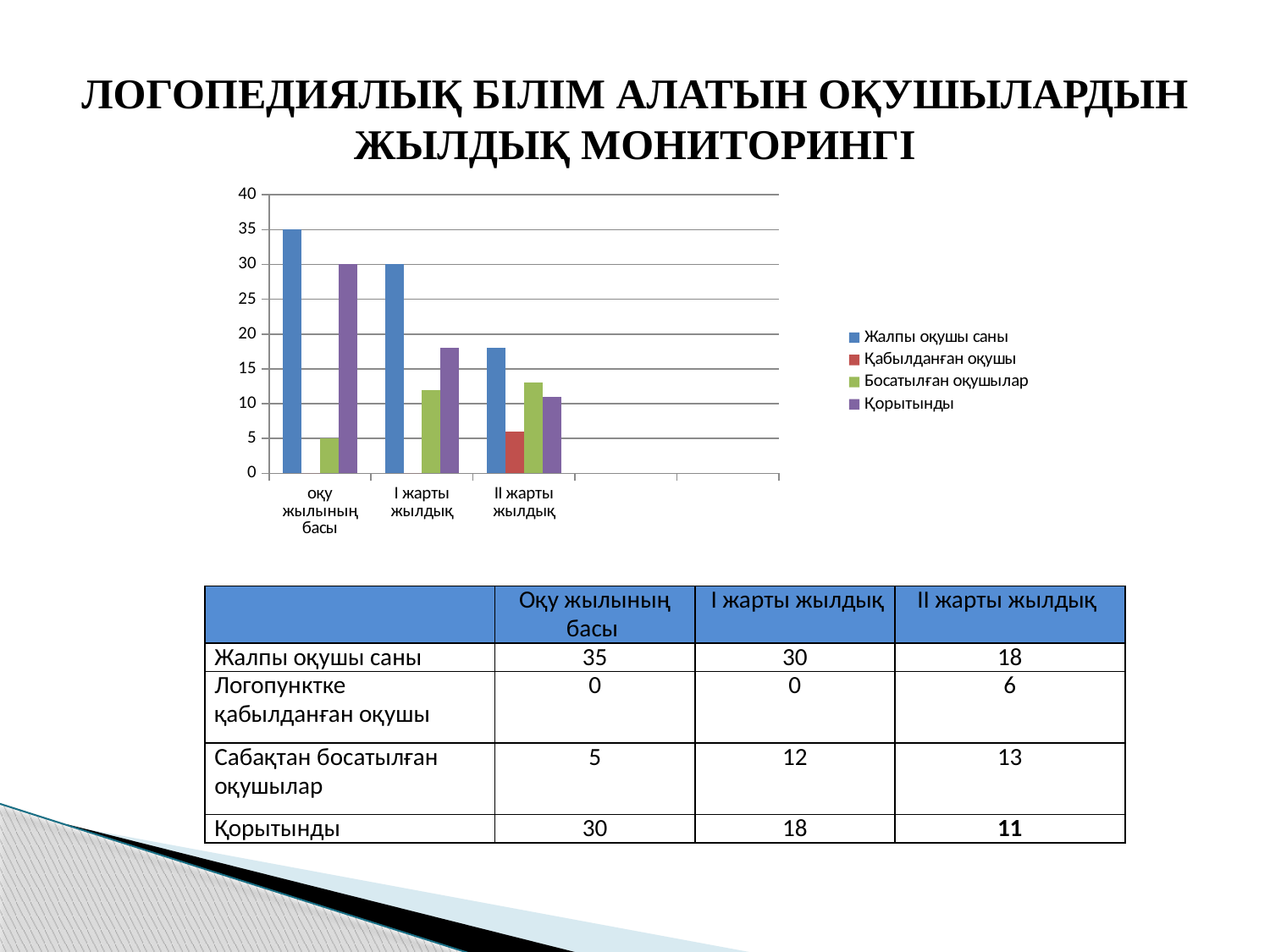
What is the difference between Жалпы оқушы саны for оқу жылының басы and for II жарты жылдық? 17 How many categories are shown on the x axis of the chart? 3 How many series does the chart legend list? 4 What kind of chart is shown on the slide? bar chart Which category has the lowest value for Қорытынды? II жарты жылдық What is the value of Босатылған оқушылар for I жарты жылдық? 12 Does the value of Жалпы оқушы саны rise or fall across the categories from оқу жылының басы to II жарты жылдық? fall Which category has the highest value for Жалпы оқушы саны? оқу жылының басы What is the value of Қорытынды for II жарты жылдық? 11 Which is larger: Босатылған оқушылар for II жарты жылдық or Қорытынды for II жарты жылдық? Босатылған оқушылар What is the value of Жалпы оқушы саны for оқу жылының басы? 35 Which series is shown in purple in the chart legend? Қорытынды